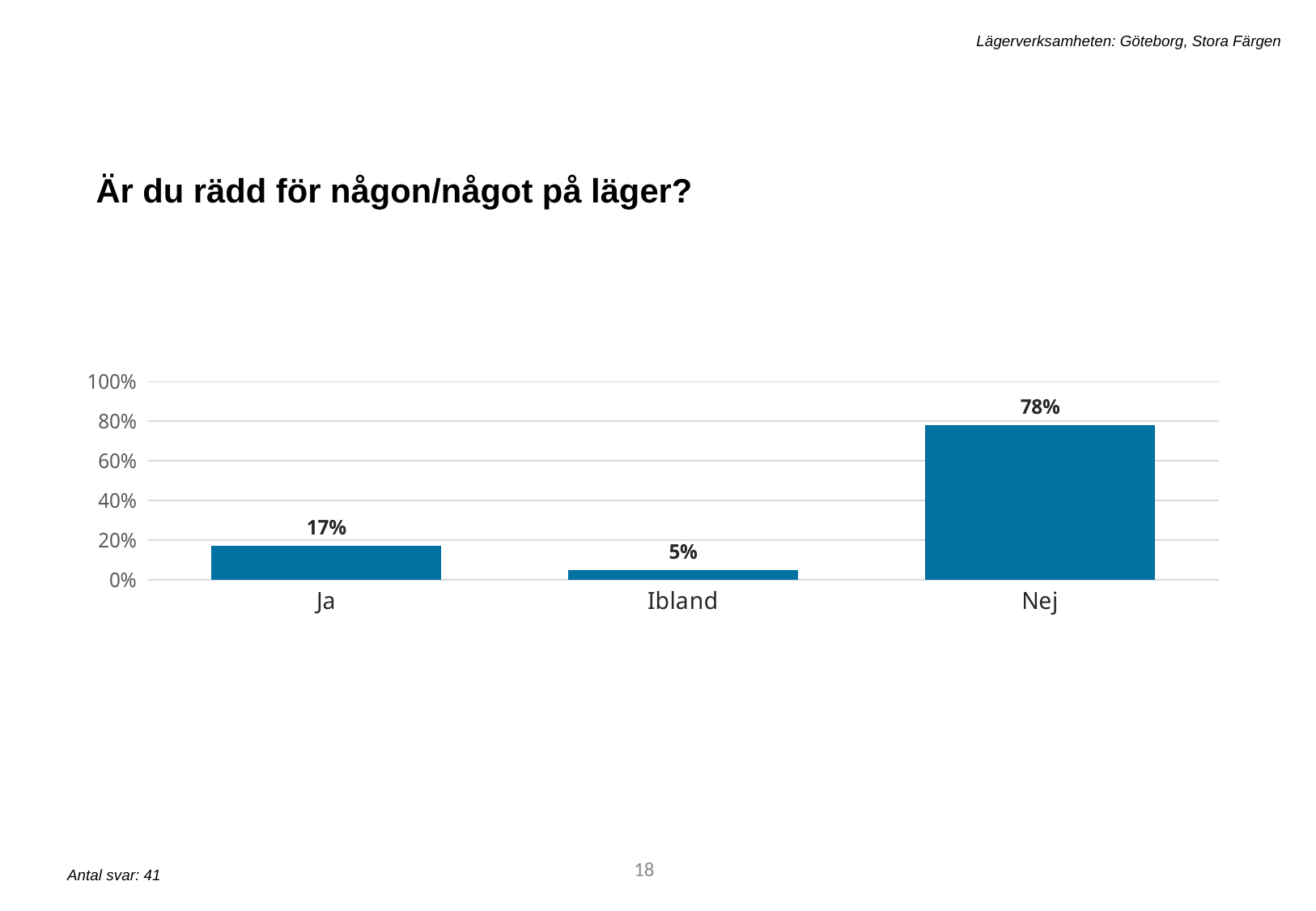
What is the difference between the values for Ja and Ibland? 12% What is the difference between the values for Nej and Ja? 61% How many categories are shown on the x axis? 3 Which is larger, the value for Ja or the value for Ibland? Ja Is the value for Nej greater or less than 60%? greater What is the value for Nej? 78% Which category has the highest value? Nej What is the value for Ja? 17% What is the title of the chart? Är du rädd för någon/något på läger? What is the value for Ibland? 5% What kind of chart is shown on the slide? bar chart Which category has the lowest value? Ibland